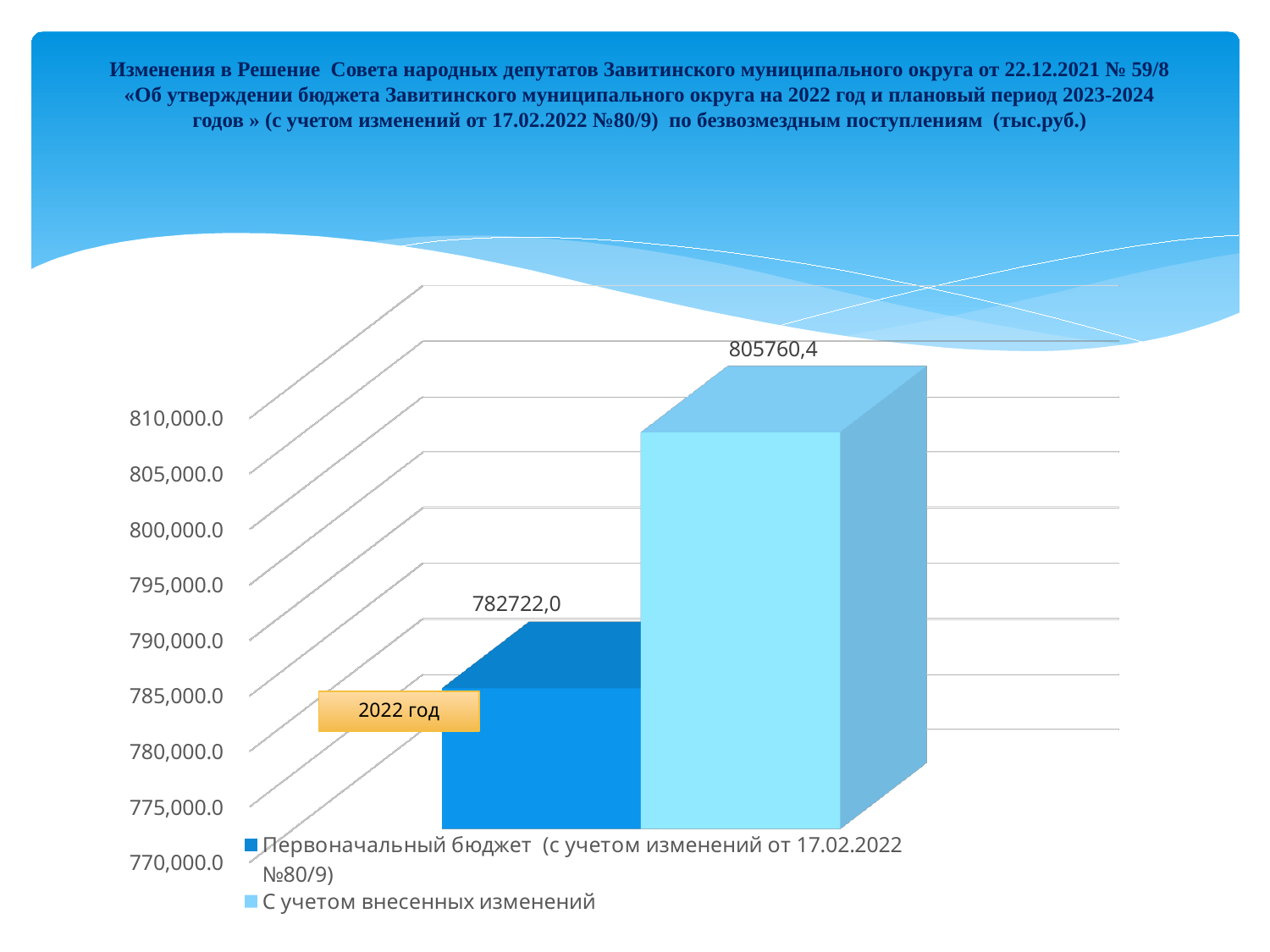
What is the value for the series "Первоначальный бюджет (с учетом изменений от 17.02.2022 №80/9)"? 782722,0 Which series has the lower value? Первоначальный бюджет (с учетом изменений от 17.02.2022 №80/9) How many series does the legend list? 2 What is the value for the series "С учетом внесенных изменений"? 805760,4 What is the difference between the value for "С учетом внесенных изменений" and the value for "Первоначальный бюджет (с учетом изменений от 17.02.2022 №80/9)"? 23038,4 Is the value for "С учетом внесенных изменений" larger or smaller than the value for "Первоначальный бюджет (с учетом изменений от 17.02.2022 №80/9)"? larger How many categories are shown on the x axis? 1 Is the value for "С учетом внесенных изменений" greater or less than 800,000.0? greater What kind of chart is shown on the slide? bar chart Which series has the higher value? С учетом внесенных изменений What is the category label shown on the chart? 2022 год Is the value for "Первоначальный бюджет (с учетом изменений от 17.02.2022 №80/9)" greater or less than 790,000.0? less